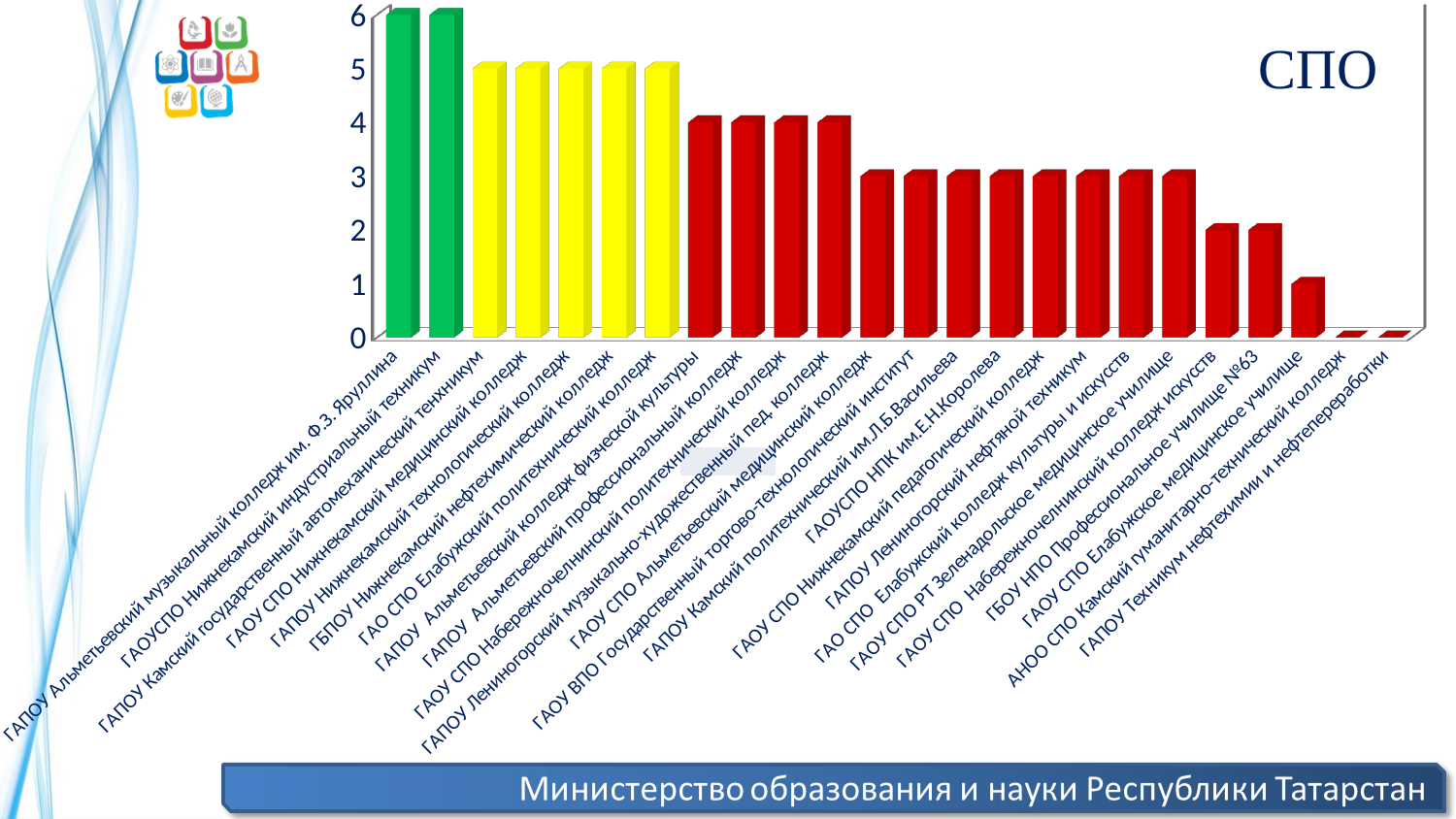
Do the values generally rise or fall moving from left to right along the x axis? fall What is the title shown in the top right corner of the chart? СПО What is the value for ГАПОУ Альметьевский музыкальный колледж им. Ф.З. Яруллина? 6 What is the value for ГАПОУ Камский государственный автомеханический техникум? 5 Which is larger: the value for ГАПОУ Камский государственный автомеханический техникум or the value for ГАОУ СПО Елабужское медицинское училище? ГАПОУ Камский государственный автомеханический техникум What is the value for ГАПОУ Альметьевский колледж физической культуры? 4 What is the value for ГБОУ НПО Профессиональное училище №63? 2 What is the value for ГАОУ СПО Елабужское медицинское училище? 1 What is the difference between the value for ГАПОУ Альметьевский музыкальный колледж им. Ф.З. Яруллина and the value for ГБОУ НПО Профессиональное училище №63? 4 What is the value for ГАОУСПО Нижнекамский индустриальный техникум? 6 What type of chart is shown on the slide? bar chart What is the value for ГАПОУ Техникум нефтехимии и нефтепереработки? 0